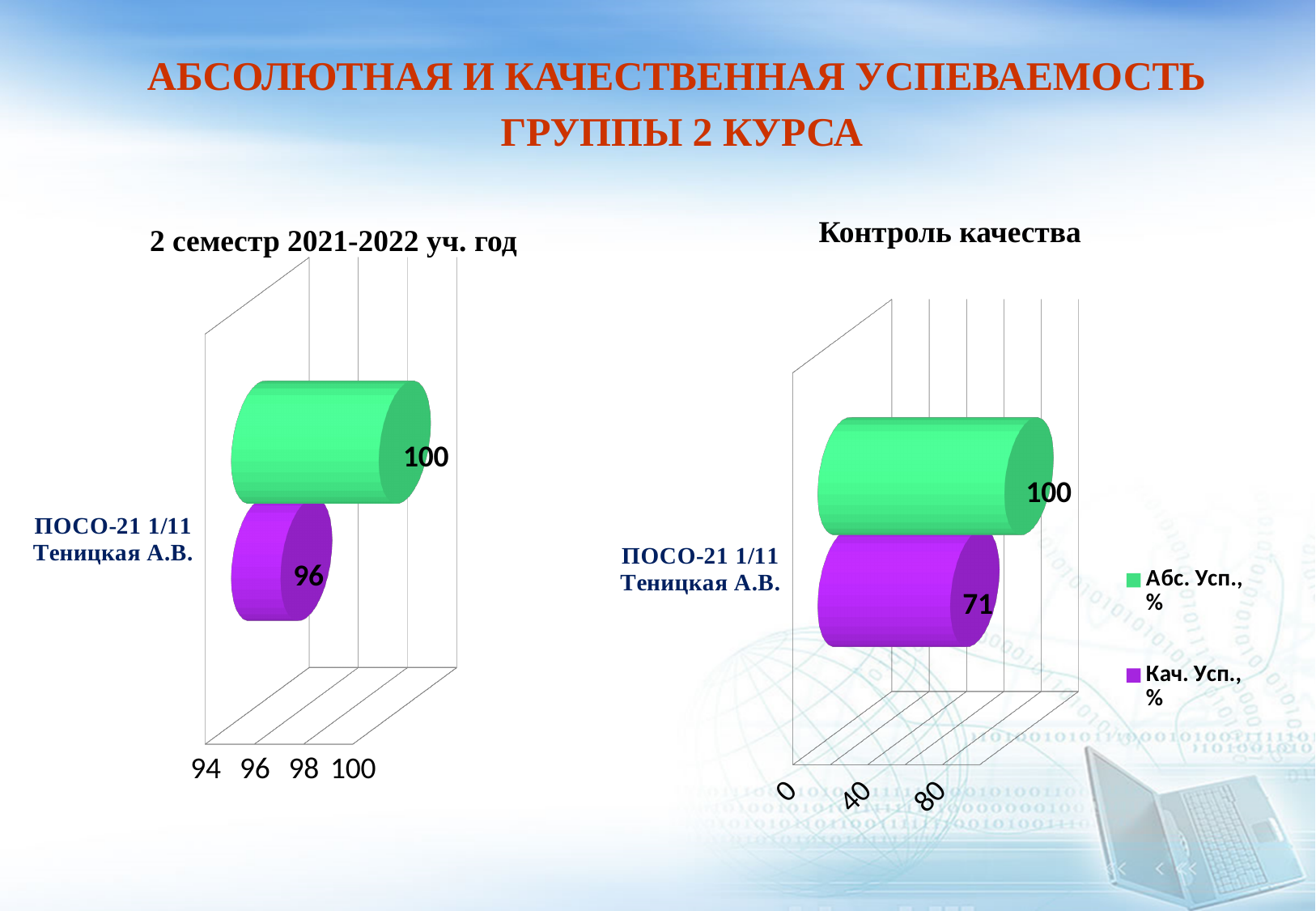
In the chart titled "Контроль качества", what is the value of Кач. Усп., % for ПОСО-21 1/11 Теницкая А.В.? 71 In the chart titled "Контроль качества", which is larger, Абс. Усп., % or Кач. Усп., %? Абс. Усп., % In the chart titled "Контроль качества", what is the value of Абс. Усп., % for ПОСО-21 1/11 Теницкая А.В.? 100 In the chart titled "Контроль качества", what is the difference between Абс. Усп., % and Кач. Усп., %? 29 In the chart titled "Контроль качества", which colour represents Кач. Усп., %? purple What kind of chart is the chart titled "Контроль качества"? bar chart In the chart titled "2 семестр 2021-2022 уч. год", what is the difference between the green bar and the purple bar? 4 In the chart titled "2 семестр 2021-2022 уч. год", what is the value of the purple bar for ПОСО-21 1/11 Теницкая А.В.? 96 In the chart titled "2 семестр 2021-2022 уч. год", which bar is larger, the green one or the purple one? the green one In the chart titled "Контроль качества", is the value of Кач. Усп., % greater or less than 80? less In the chart titled "2 семестр 2021-2022 уч. год", what is the value of the green bar for ПОСО-21 1/11 Теницкая А.В.? 100 How many series does the legend of the chart titled "Контроль качества" list? 2